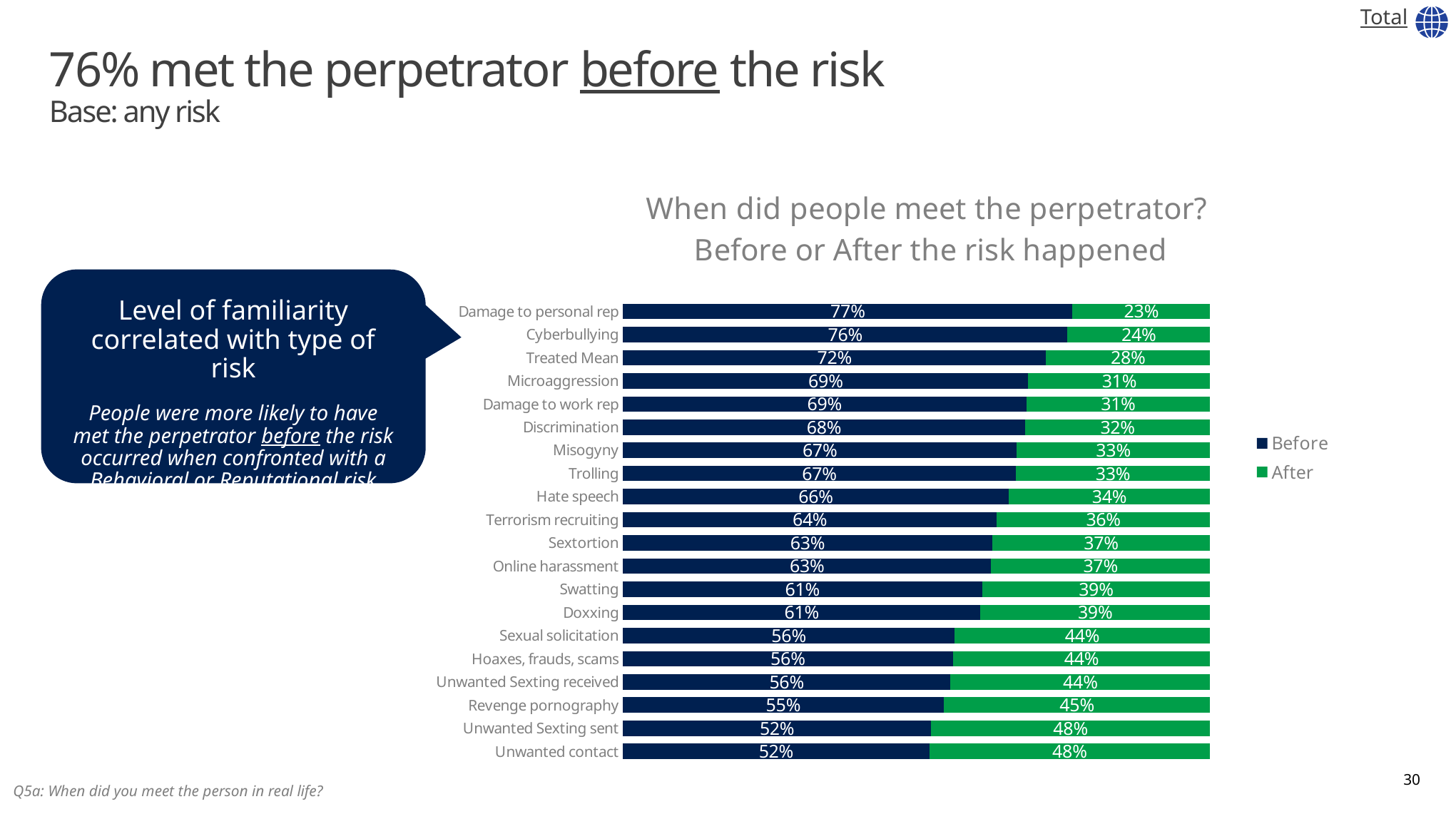
What is the 'Before' value for Revenge pornography? 55% Which category has the lowest 'After' value? Damage to personal rep Which colour represents the 'After' series in the chart? Green How many series does the legend list? 2 How many categories are shown in the chart? 20 What kind of chart is shown on the slide? Stacked bar chart What is the difference between the 'Before' and 'After' values for Sextortion? 26% Which category has the highest 'Before' value? Damage to personal rep What is the 'Before' value for Cyberbullying? 76% What is the 'After' value for Hate speech? 34% Which is larger: the 'Before' value for Treated Mean or the 'Before' value for Doxxing? Treated Mean What is the total of the stacked bar for Unwanted contact? 100%